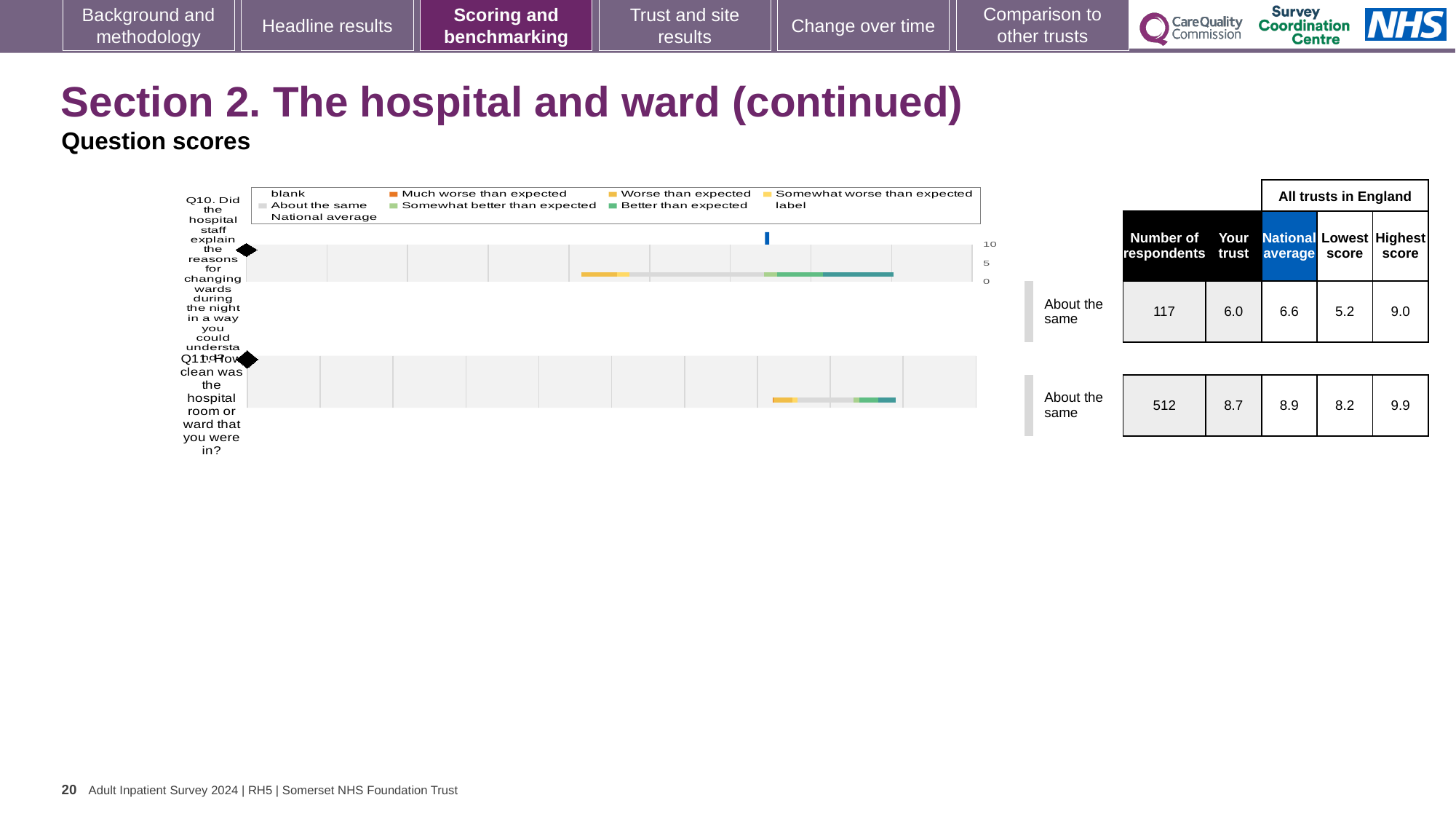
What is the 'Your trust' score for Q10? 6.0 What is the highest score among all trusts in England for Q10? 9.0 What is the difference between the highest and lowest scores for Q10? 3.8 For Q11, which is larger: the trust's score or the national average? National average How many questions are plotted on the slide? 2 What is the 'Your trust' score for Q11? 8.7 How many respondents answered Q10 (explaining reasons for changing wards during the night)? 117 What is the lowest score among all trusts in England for Q11? 8.2 What is the national average score for Q10? 6.6 What kind of chart is used to show the question scores? Bar chart What benchmark category is shown for Q11? About the same How many respondents answered Q11 (how clean was the hospital room or ward)? 512